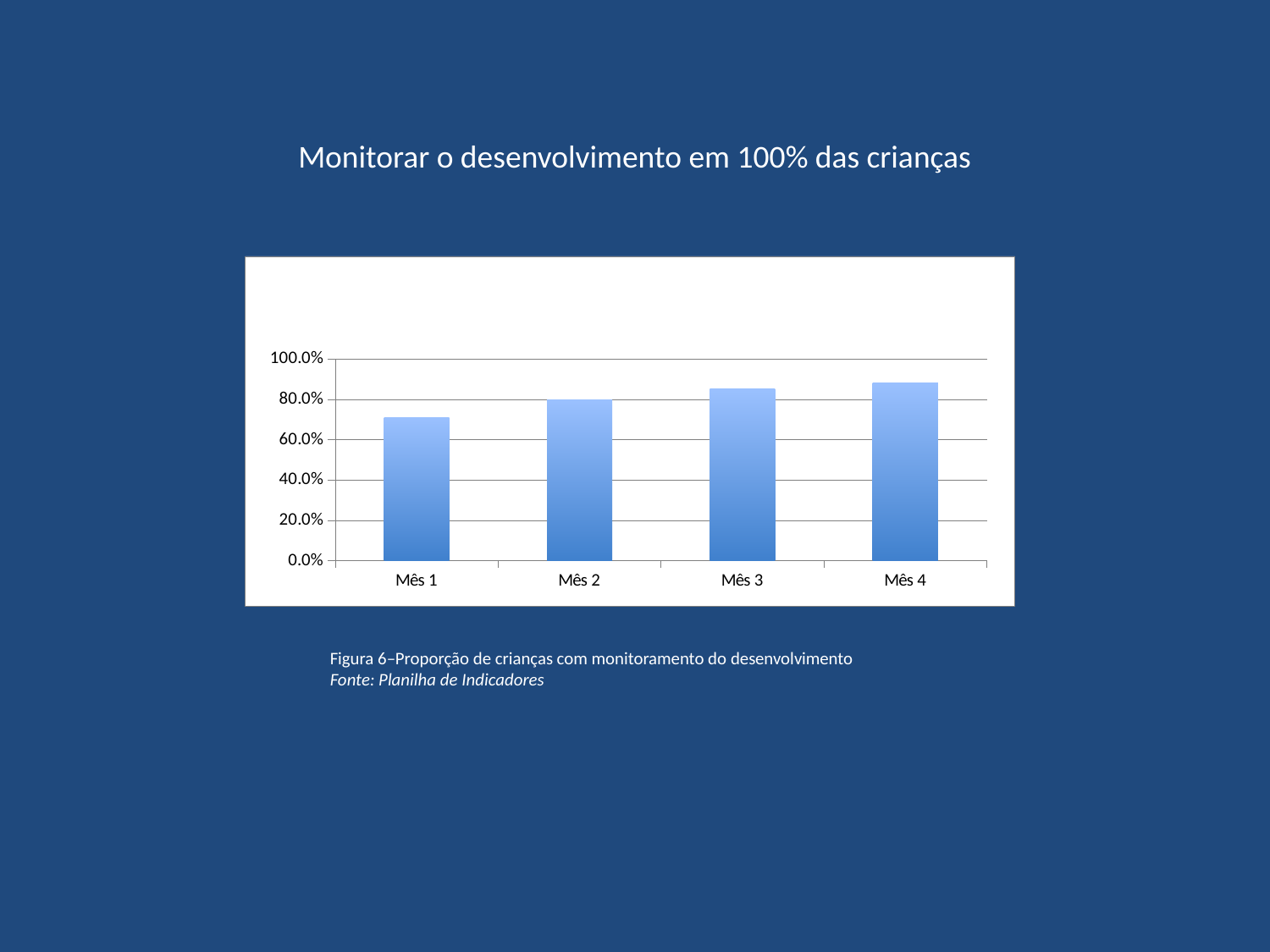
Is the value for Mês 3 greater or less than 80.0%? greater Which is larger, the value for Mês 1 or the value for Mês 3? Mês 3 Is the value for Mês 1 greater or less than 80.0%? less Which is larger, the value for Mês 1 or the value for Mês 4? Mês 4 Is the value for Mês 1 greater or less than 60.0%? greater How many categories are shown on the x axis of the chart? 4 What kind of chart is shown on the slide? bar chart What is the title shown above the chart on the slide? Monitorar o desenvolvimento em 100% das crianças Do the values rise or fall from Mês 1 to Mês 4? rise Which month has the lowest value in the chart? Mês 1